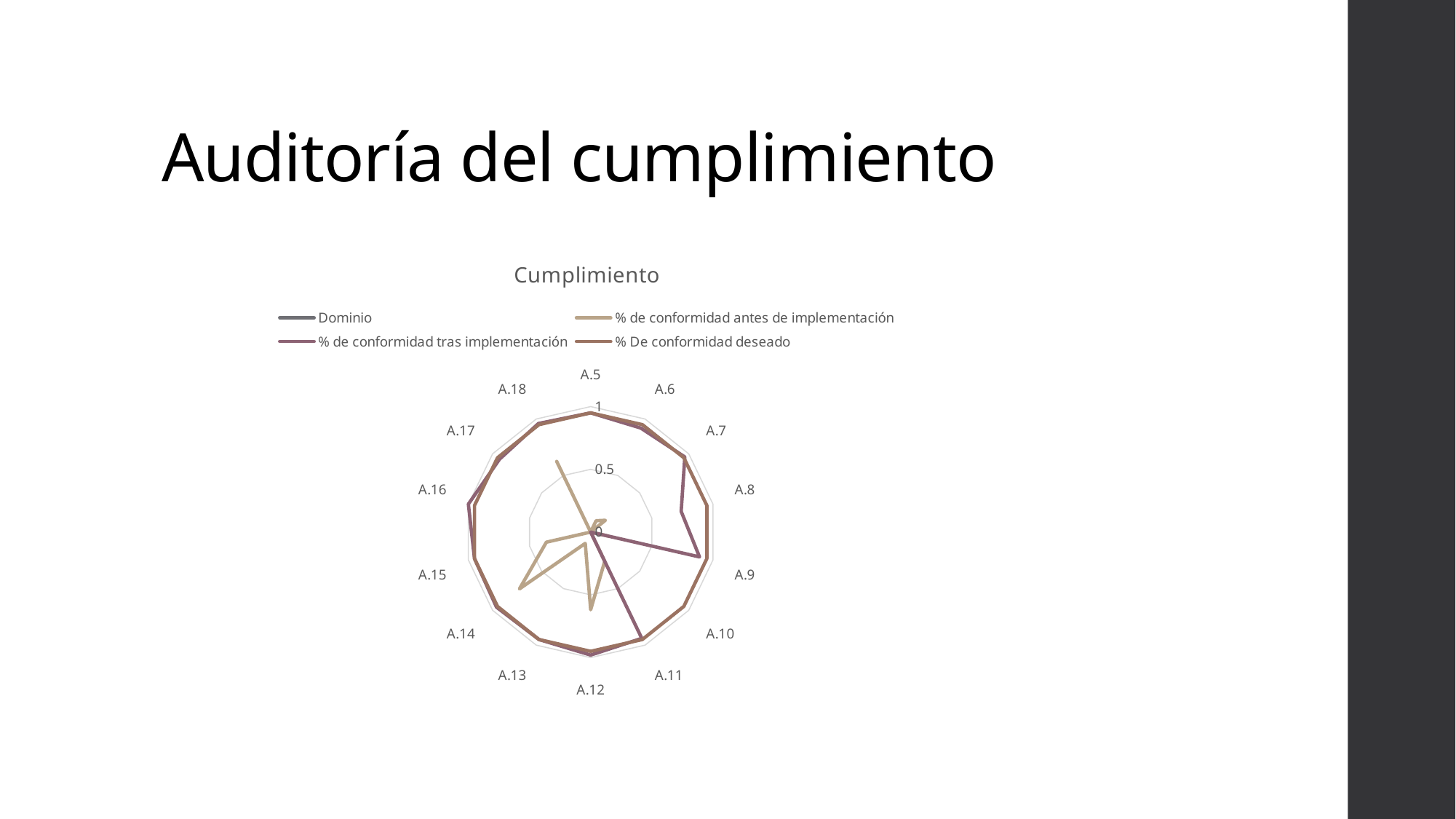
For A.9, which series is larger: '% de conformidad antes de implementación' or '% de conformidad tras implementación'? % de conformidad tras implementación Is the value of '% de conformidad tras implementación' for A.10 greater or less than 0.5? less Which category comes first, at the top of the radar chart? A.5 For '% de conformidad tras implementación', which is larger: the value for A.9 or the value for A.12? A.12 Is the value of '% de conformidad tras implementación' for A.9 greater or less than 0.5? greater What kind of chart is shown on the slide? radar chart What is the title of the chart? Cumplimiento How many categories are plotted around the radar chart? 14 Is the value of '% de conformidad antes de implementación' for A.8 greater or less than 0.5? less How many series does the legend list? 4